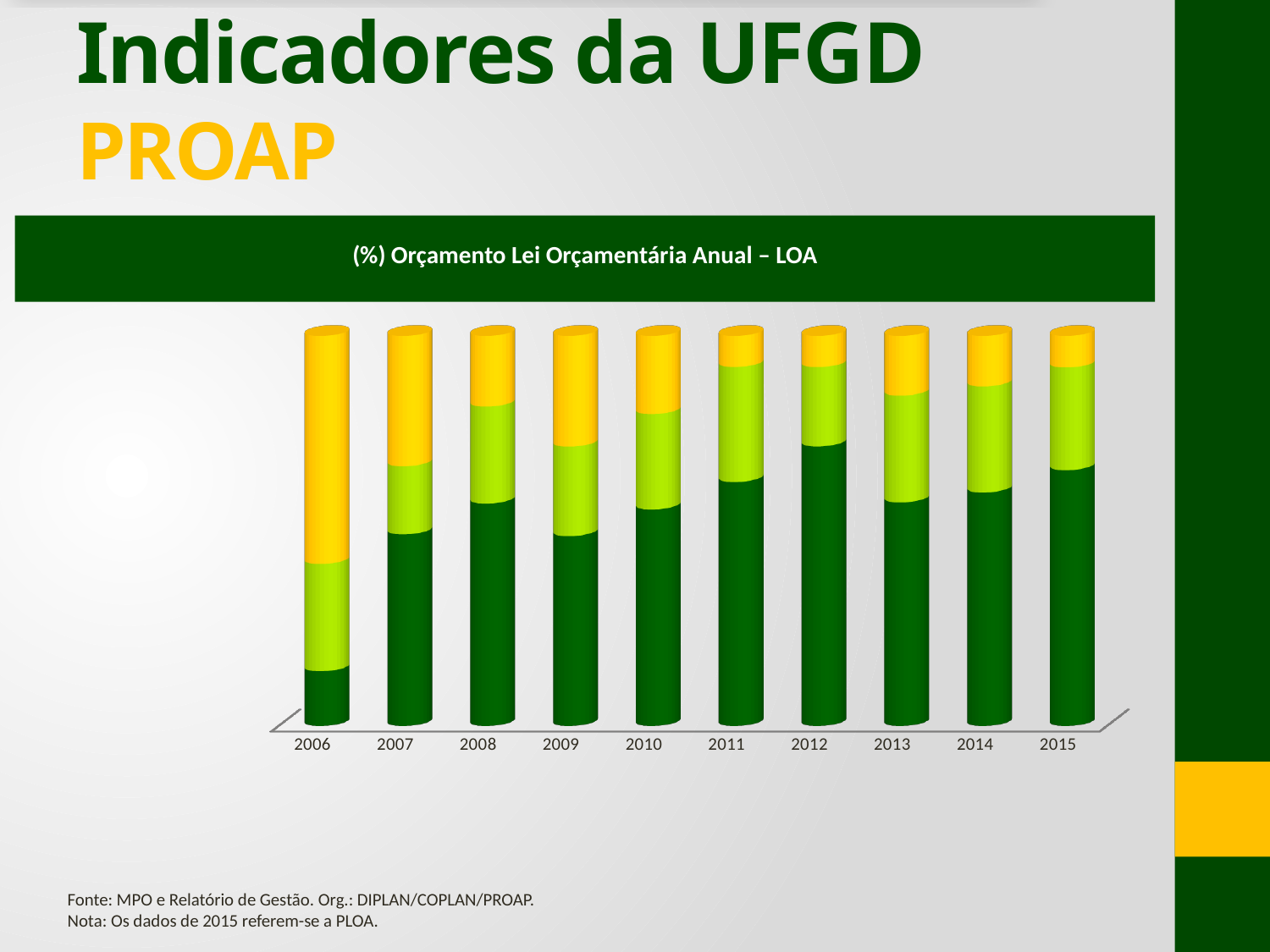
Is the yellow (top) segment larger in 2006 or in 2012? 2006 In which year is the dark green (bottom) segment the smallest? 2006 What is the title shown in the green band above the chart? (%) Orçamento Lei Orçamentária Anual – LOA What is the last year shown on the x axis? 2015 How many years are shown on the x axis of the chart? 10 What kind of chart is shown on the slide? Stacked bar chart In which year is the yellow (top) segment the largest? 2006 What is the first year shown on the x axis? 2006 How many coloured segments make up each bar in the chart? 3 Does the dark green (bottom) segment of the bars generally rise or fall from 2006 to 2015? Rise Does the yellow (top) segment of the bars generally rise or fall from 2006 to 2015? Fall Is the dark green (bottom) segment larger in 2006 or in 2015? 2015